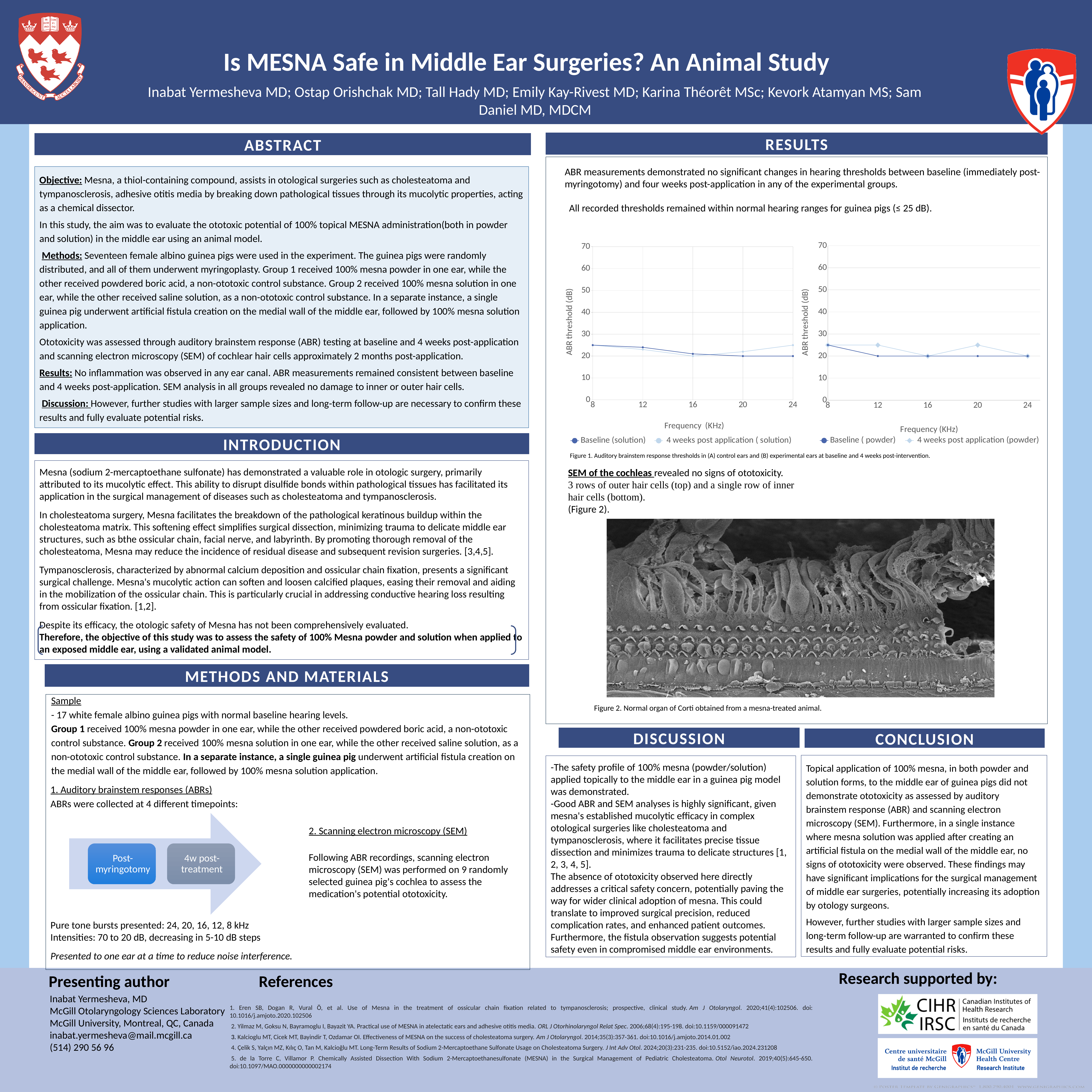
In the right chart (powder), is the Baseline (powder) value at 24 KHz greater or less than 10? greater In the left chart (solution), is the Baseline (solution) value at 8 KHz greater or less than 30? less How many frequency points are plotted along the x axis of the left chart (solution)? 5 What is the y-axis label of the charts in the Results section? ABR threshold (dB) What kind of chart is the left chart in the Results section? line chart In the left chart (solution), does the Baseline (solution) series rise or fall from 8 KHz to 24 KHz? fall What are the two legend entries of the right chart in the Results section? Baseline ( powder) and 4 weeks post application (powder) In the left chart (solution), is the 4 weeks post application (solution) value at 24 KHz greater or less than 40? less How many series does the legend of the left chart (solution) list? 2 How many series does the legend of the right chart (powder) list? 2